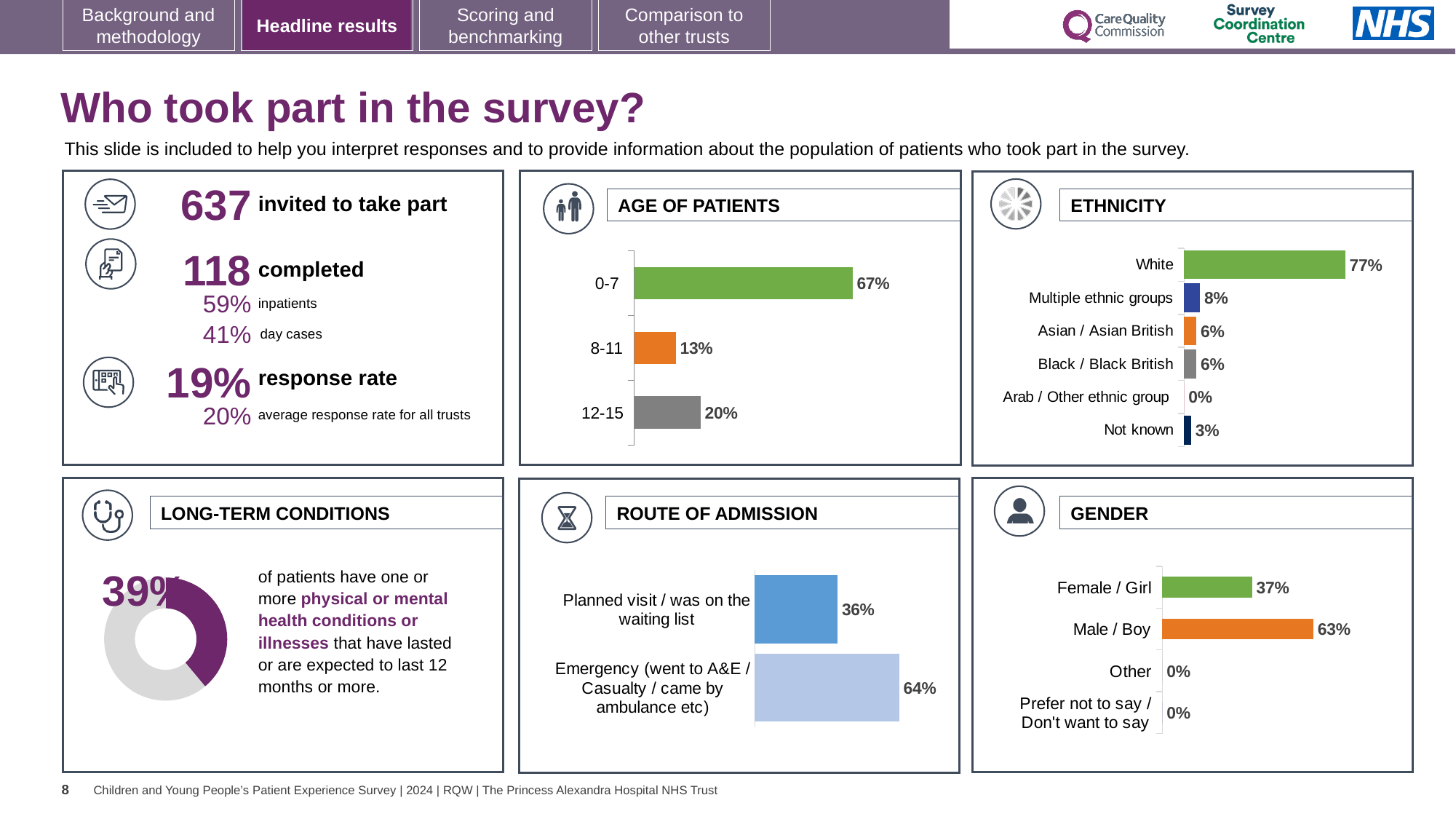
In the ROUTE OF ADMISSION chart, what is the value for Planned visit / was on the waiting list? 36% In the GENDER chart, what is the difference between the Male / Boy and Female / Girl values? 26% In the LONG-TERM CONDITIONS chart, what percentage of patients have one or more long-term conditions? 39% What kind of chart is the GENDER chart? Bar chart In the ETHNICITY chart, what is the value for Multiple ethnic groups? 8% In the AGE OF PATIENTS chart, what is the difference between the 0-7 and 12-15 values? 47% In the AGE OF PATIENTS chart, what is the value for the 0-7 age group? 67% In the ETHNICITY chart, which category has the highest value? White How many categories does the ETHNICITY chart show? 6 In the ROUTE OF ADMISSION chart, which route has the larger value: Planned visit / was on the waiting list or Emergency? Emergency (went to A&E / Casualty / came by ambulance etc) In the ETHNICITY chart, what is the value for Not known? 3% In the AGE OF PATIENTS chart, which age group has the lowest value? 8-11